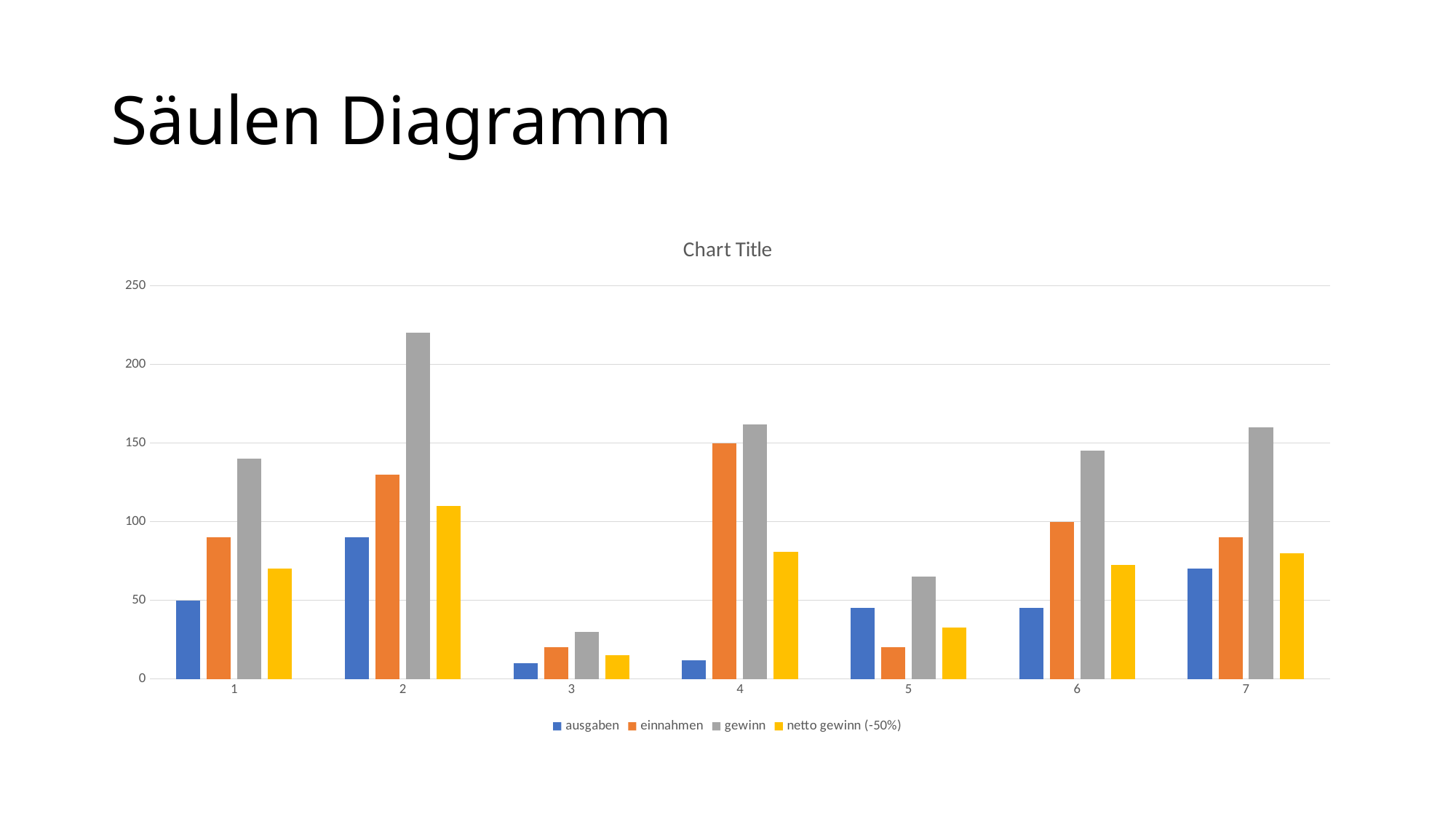
For which category is gewinn lowest? 3 What is the value of einnahmen for category 4? 150 What is the value of einnahmen for category 6? 100 Is the value of gewinn for category 2 greater or less than 200? greater How many series does the legend list? 4 What is the value of ausgaben for category 1? 50 How many categories are shown on the x axis? 7 Which is larger: gewinn for category 4 or gewinn for category 6? category 4 What kind of chart is shown on the slide? bar chart What is the title shown above the chart? Chart Title Is the value of ausgaben for category 3 greater or less than 50? less For which category is gewinn highest? 2